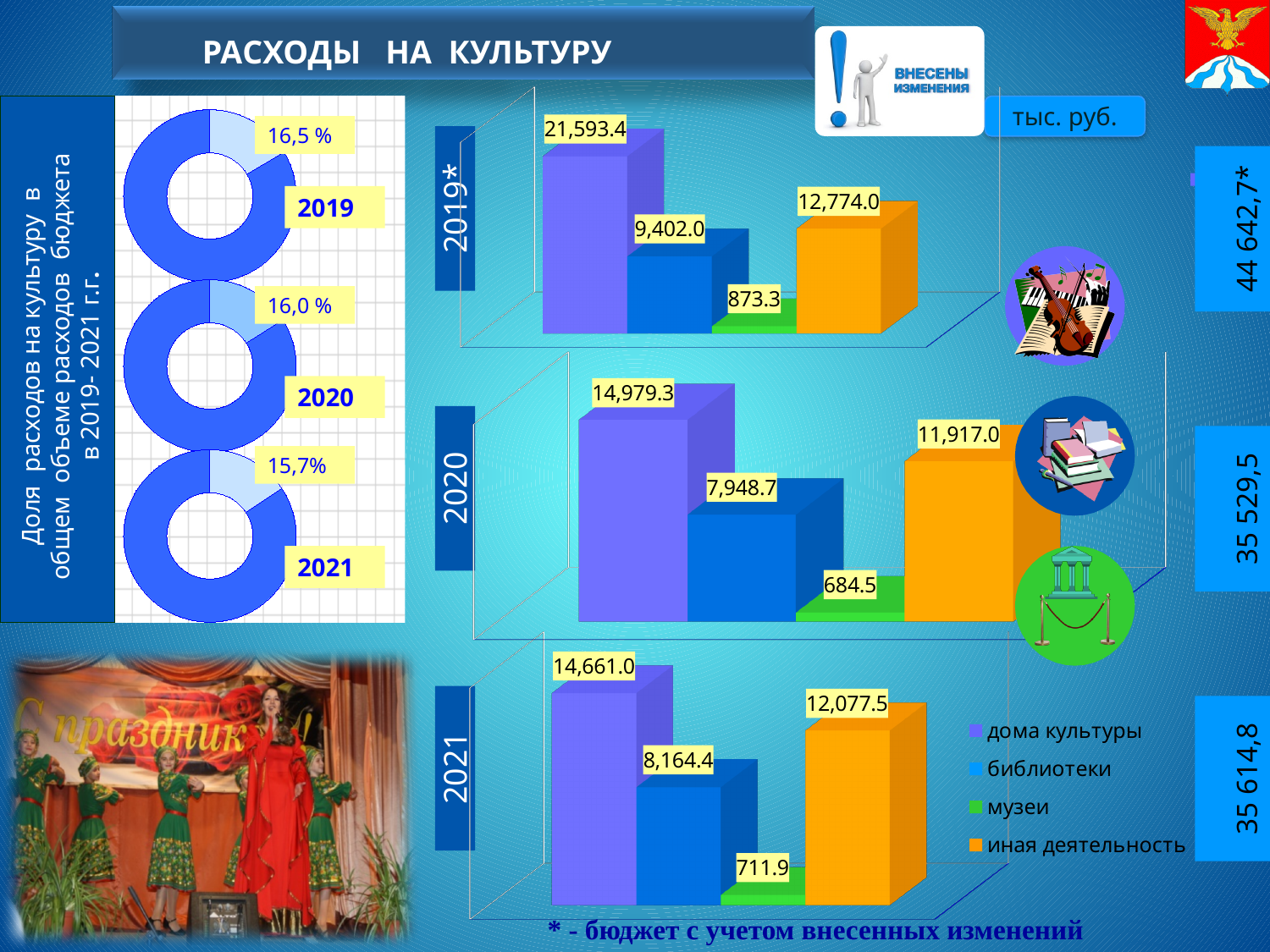
In the 2019* bar chart, which category has the lowest value? музеи How many series does the legend of the bar charts list? 4 In the 2019* bar chart, what is the value for дома культуры? 21,593.4 In the 2019* bar chart, what is the difference between дома культуры and иная деятельность? 8,819.4 In the donut charts on the left, do the shares rise or fall from 2019 to 2021? fall In the 2021 bar chart, which is larger: библиотеки or иная деятельность? иная деятельность What type of chart is used to show the 2020 expenditure by category? bar chart In the 2020 bar chart, what is the value for библиотеки? 7,948.7 In the donut chart on the left, what share is shown for 2020? 16,0 % In the 2020 bar chart, which category has the highest value? дома культуры In the 2021 bar chart, what is the value for музеи? 711.9 In the 2021 bar chart, what is the value for иная деятельность? 12,077.5